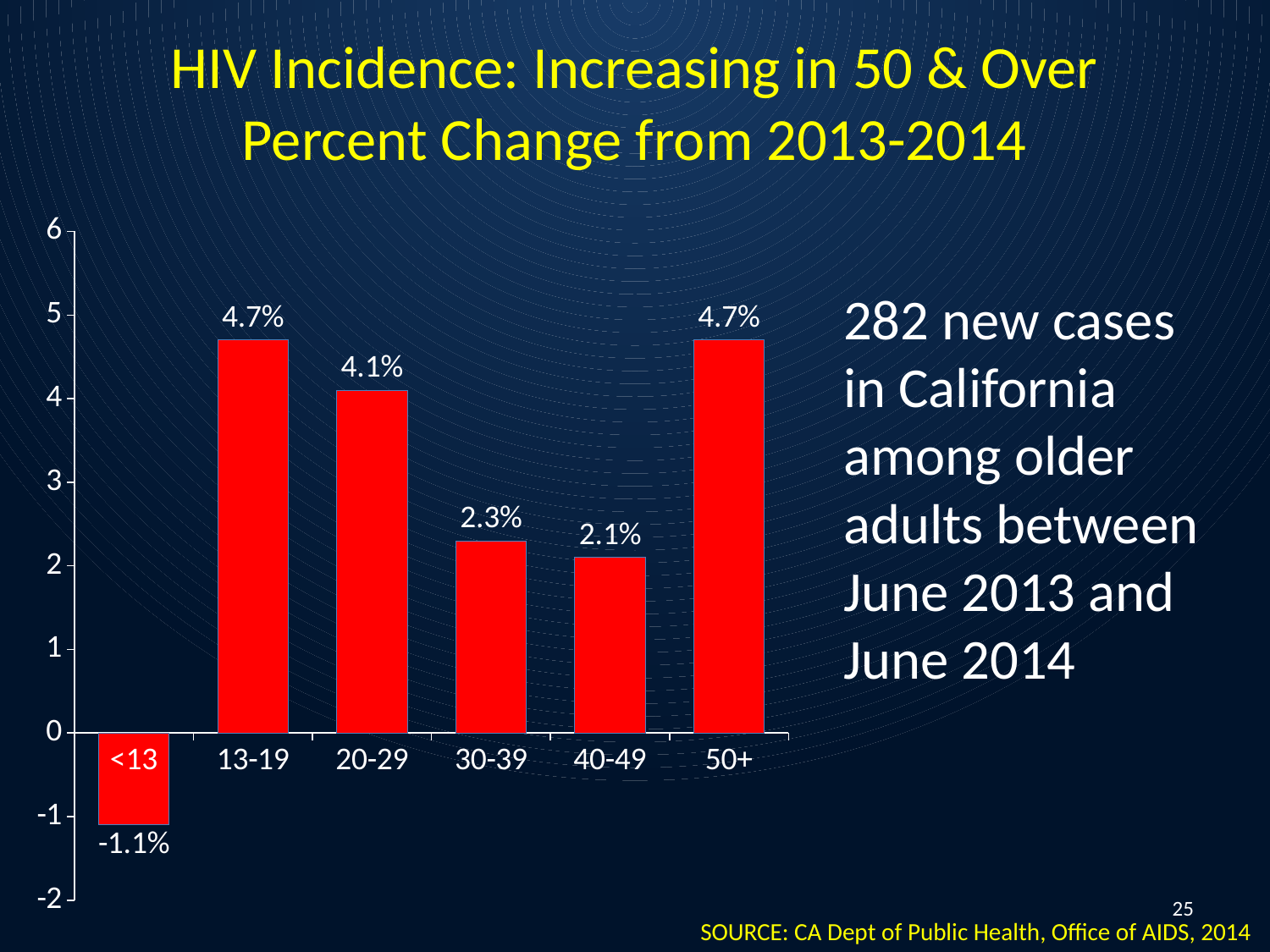
What is the percent change for the 50+ age group? 4.7% How many age groups are shown in the chart? 6 Which age group has the lowest percent change? <13 What colour are the bars in the chart? Red What is the difference between the percent change for 13-19 and for 30-39? 2.4% What is the percent change for the <13 age group? -1.1% What is the percent change for the 40-49 age group? 2.1% Which has a larger percent change, the 20-29 group or the 40-49 group? 20-29 Is the value for the 30-39 age group greater or less than 3? less Which age groups share the highest percent change? 13-19 and 50+ What is the percent change for the 20-29 age group? 4.1% What type of chart is shown on the slide? Bar chart